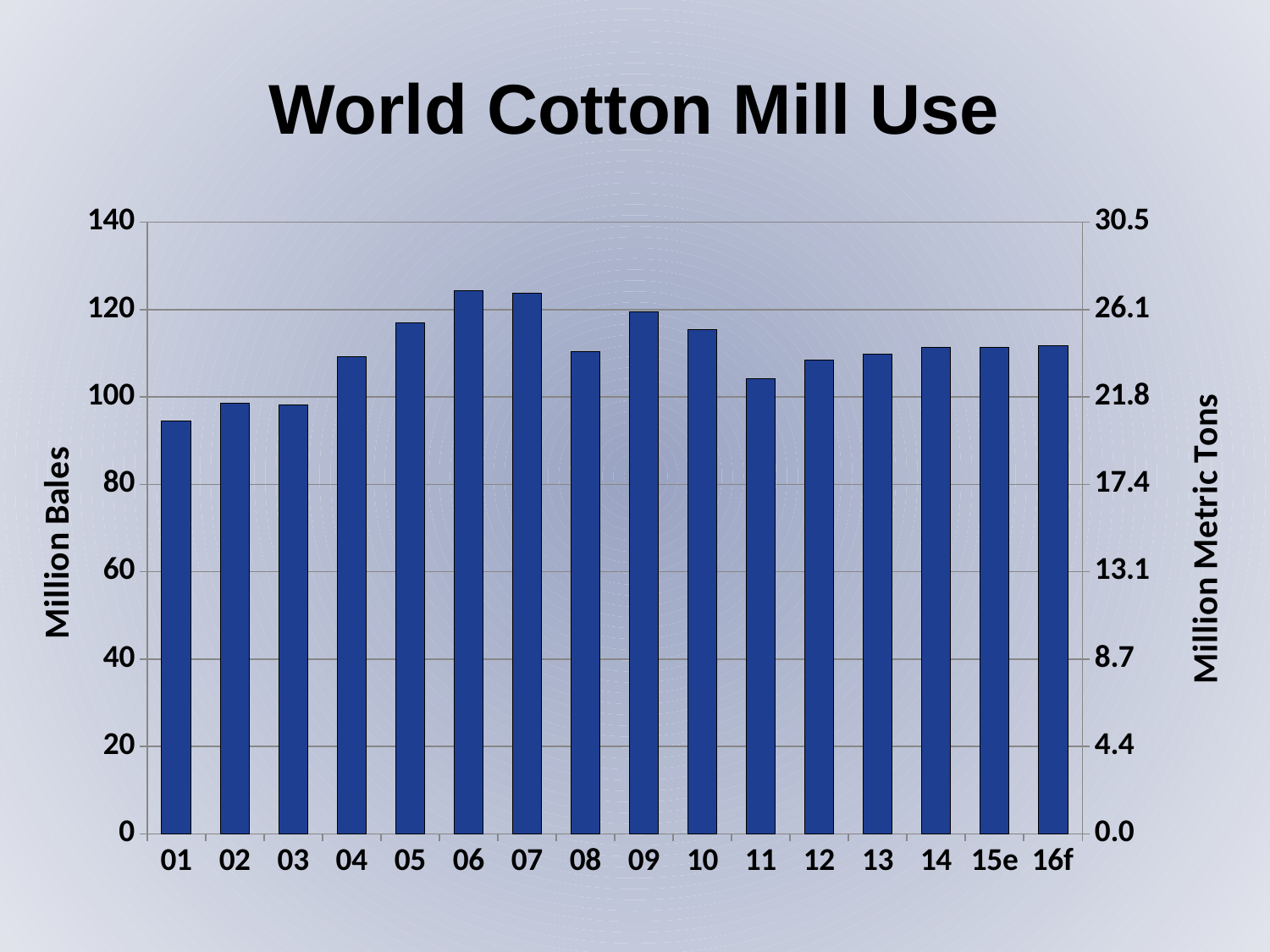
Is the value for 01 greater or less than 100 million bales? less Which year has the lowest world cotton mill use? 01 How many years (categories) are plotted on the x axis? 16 Which is larger, the value for 09 or the value for 08? 09 What is the title of the chart? World Cotton Mill Use Is the value for 06 greater or less than 120 million bales? greater Is the value for 05 greater or less than 120 million bales? less What is the label of the right-hand vertical axis? Million Metric Tons Do the values rise or fall from 01 to 06? rise What kind of chart is shown on the slide? bar chart Which is larger, the value for 04 or the value for 11? 04